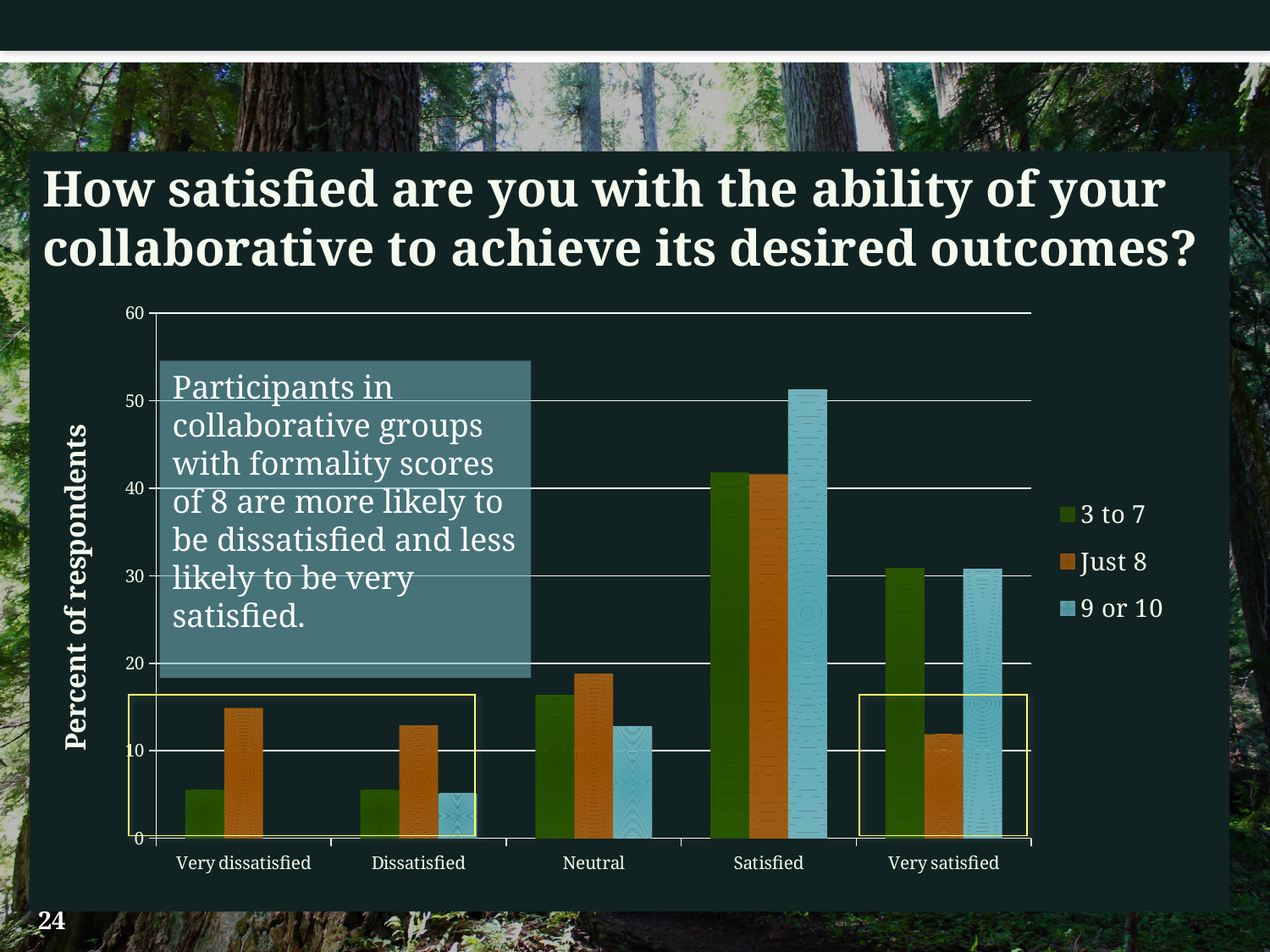
Is the value for 'Just 8' in the Very satisfied category greater or less than 20? less How many satisfaction categories are shown on the x axis? 5 In the Very satisfied category, which series has the smaller value: 'Just 8' or '9 or 10'? Just 8 How many series does the legend list? 3 In the Very dissatisfied category, which series has the larger value: '3 to 7' or 'Just 8'? Just 8 What are the three series named in the legend? 3 to 7, Just 8, 9 or 10 For the '9 or 10' series, which category has the highest bar? Satisfied Is the value for '9 or 10' in the Satisfied category greater or less than 50? greater For the 'Just 8' series, which category has the highest bar? Satisfied What kind of chart is shown on the slide? bar chart What is the label of the y axis? Percent of respondents